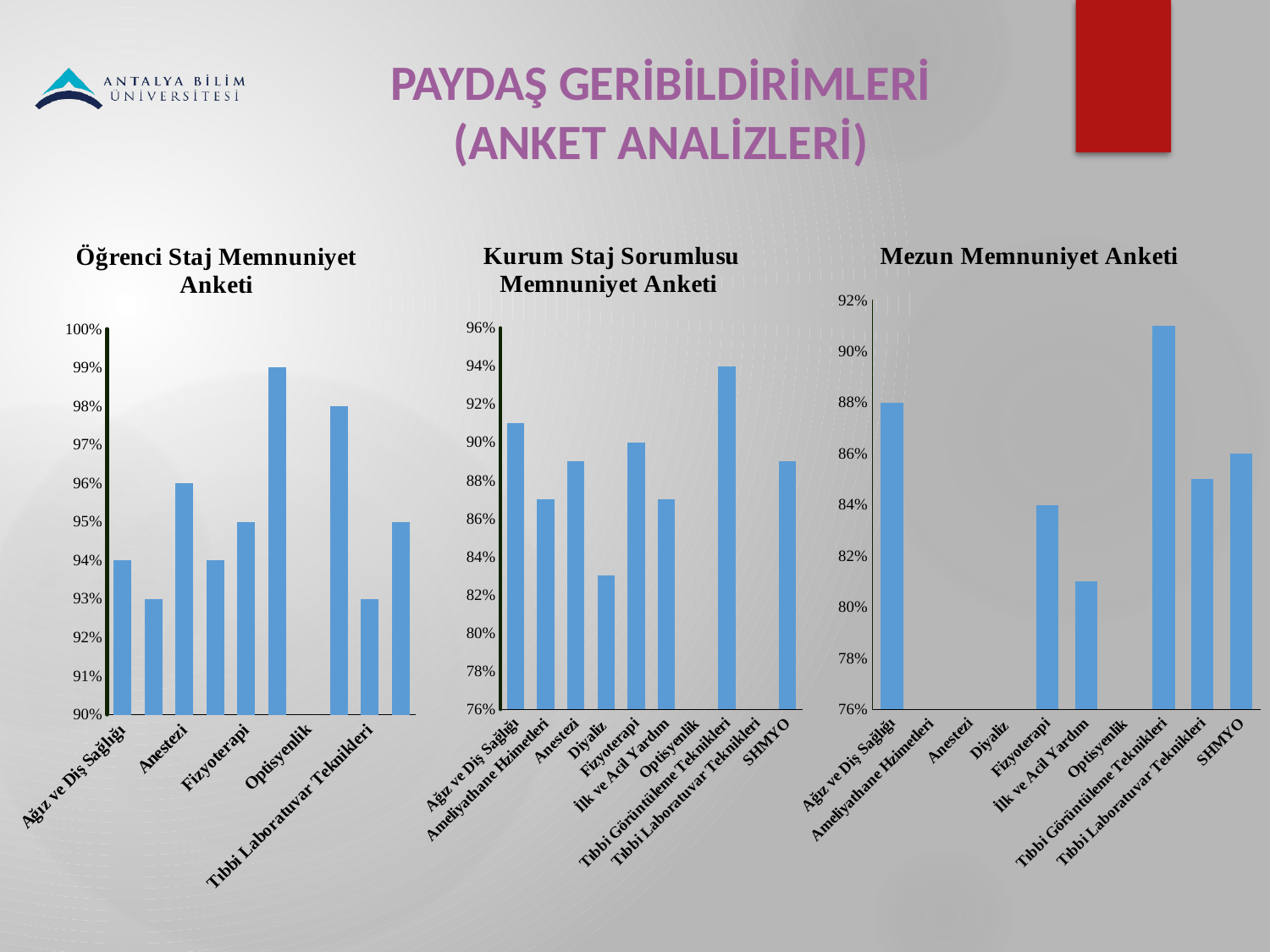
In the 'Mezun Memnuniyet Anketi' chart, what is the value for Ağız ve Diş Sağlığı? 88% In the 'Mezun Memnuniyet Anketi' chart, what is the difference between the values for Ağız ve Diş Sağlığı and Fizyoterapi? 4% What type of chart is the 'Mezun Memnuniyet Anketi' chart? Bar chart In the 'Kurum Staj Sorumlusu Memnuniyet Anketi' chart, what is the value for Fizyoterapi? 90% In the 'Kurum Staj Sorumlusu Memnuniyet Anketi' chart, which category has the lowest value? Diyaliz How many charts are shown on the slide? 3 In the 'Öğrenci Staj Memnuniyet Anketi' chart, what is the highest value plotted? 99% In the 'Öğrenci Staj Memnuniyet Anketi' chart, which is larger, the value for Ağız ve Diş Sağlığı or the value for Fizyoterapi? Fizyoterapi In the 'Kurum Staj Sorumlusu Memnuniyet Anketi' chart, is the value for Diyaliz greater or less than 84%? less In the 'Öğrenci Staj Memnuniyet Anketi' chart, what is the value for Tıbbi Laboratuvar Teknikleri? 93% In the 'Kurum Staj Sorumlusu Memnuniyet Anketi' chart, which category has the highest value? Tıbbi Görüntüleme Teknikleri In the 'Öğrenci Staj Memnuniyet Anketi' chart, what is the value for Anestezi? 96%